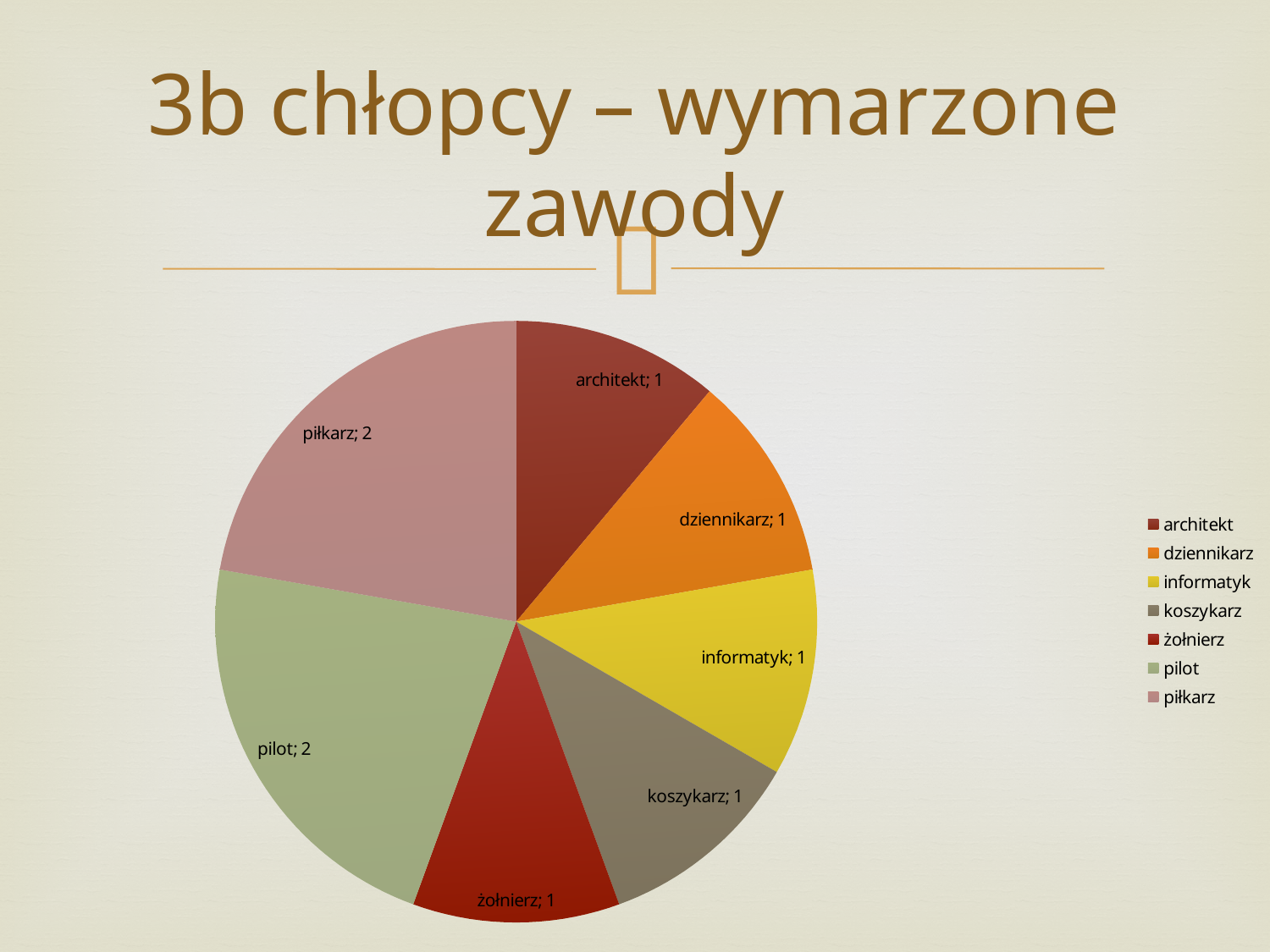
What is the title of the slide containing the chart? 3b chłopcy – wymarzone zawody What is the value for piłkarz? 2 What type of chart is shown on the slide? pie chart How many entries does the legend list? 7 What is the value for architekt? 1 Which categories have the highest value in the pie chart? pilot and piłkarz What is the total of all the values in the pie chart? 9 What is the value for koszykarz? 1 How many slices does the pie chart have? 7 What is the value for pilot? 2 What is the difference between the value for piłkarz and the value for dziennikarz? 1 Which is larger, the value for pilot or the value for żołnierz? pilot